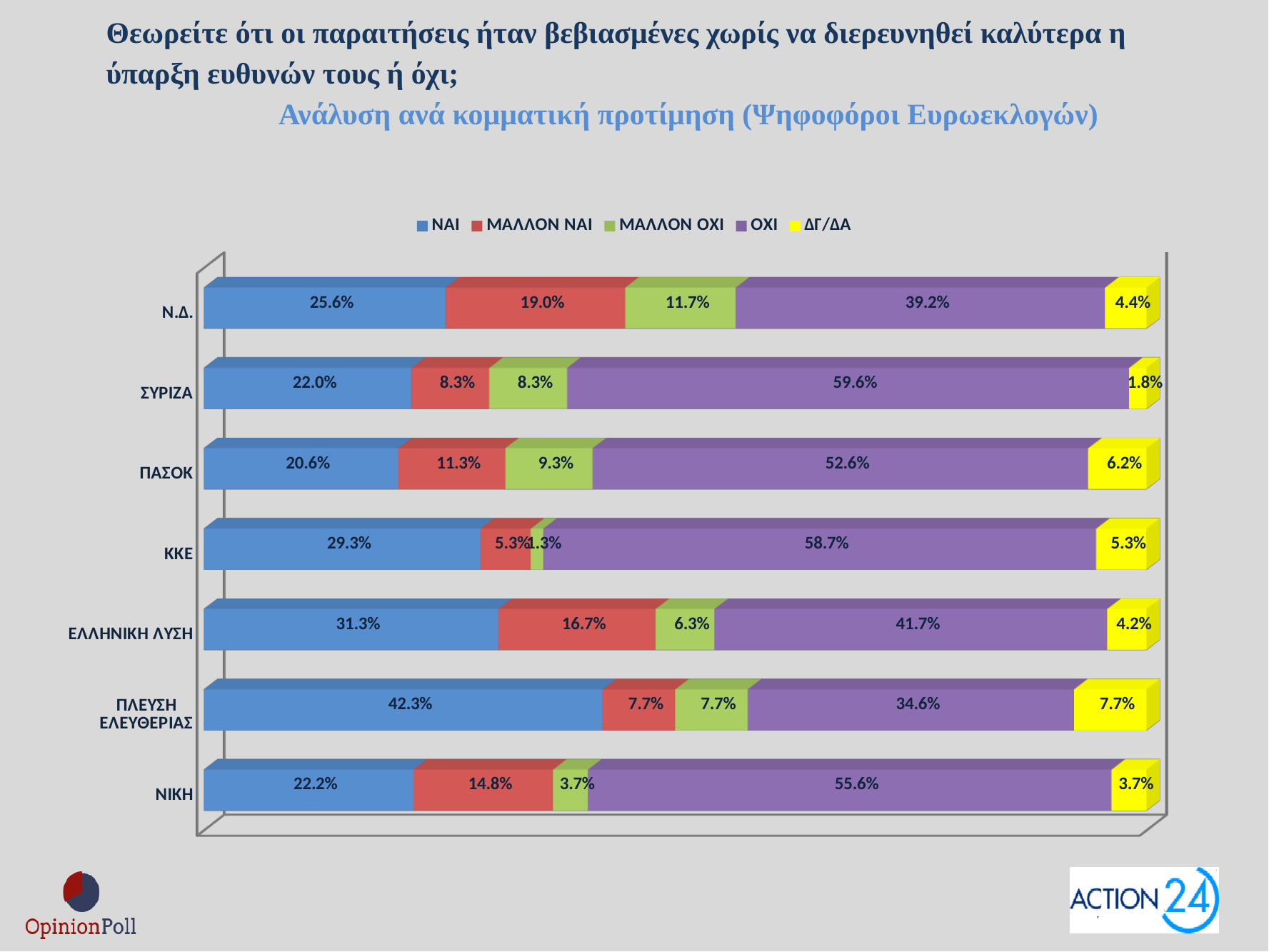
What is the total of the ΣΥΡΙΖΑ bar? 100.0% Which colour represents ΔΓ/ΔΑ in the legend? Yellow What is the difference between the ΟΧΙ and ΝΑΙ values for Ν.Δ.? 13.6% Which party has the highest ΝΑΙ value? ΠΛΕΥΣΗ ΕΛΕΥΘΕΡΙΑΣ What percentage of Ν.Δ. voters answered ΟΧΙ? 39.2% Which party has the lowest ΔΓ/ΔΑ value? ΣΥΡΙΖΑ What is the ΜΑΛΛΟΝ ΟΧΙ value for ΚΚΕ? 1.3% How many parties are shown on the chart? 7 What kind of chart is shown on the slide? Stacked bar chart How many series does the legend list? 5 What is the ΝΑΙ value for ΠΛΕΥΣΗ ΕΛΕΥΘΕΡΙΑΣ? 42.3% Which has the larger ΝΑΙ value, ΚΚΕ or ΕΛΛΗΝΙΚΗ ΛΥΣΗ? ΕΛΛΗΝΙΚΗ ΛΥΣΗ